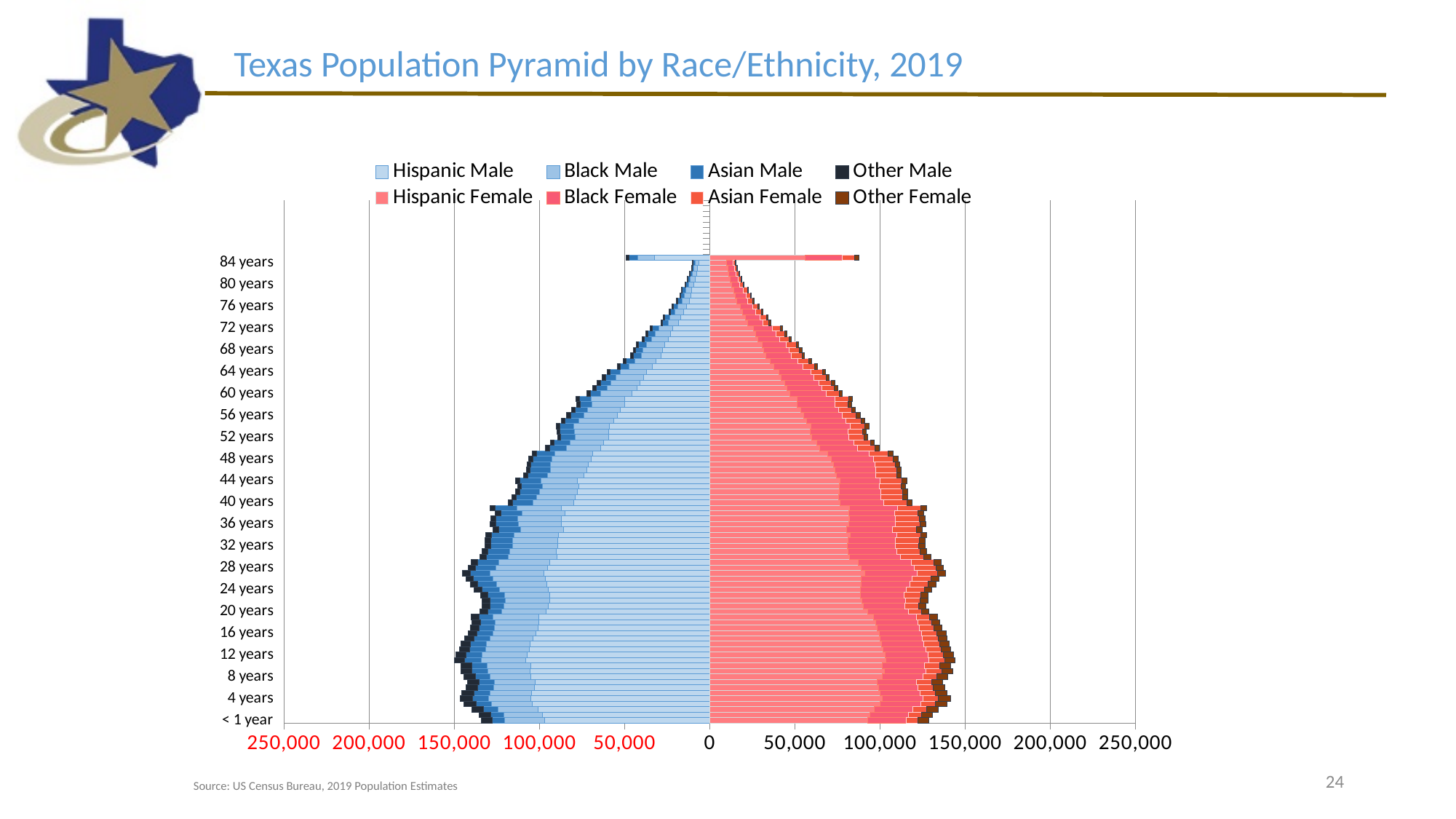
Which legend entries represent the female population? Hispanic Female, Black Female, Asian Female, Other Female Is the total male bar for 28 years greater or less than 100,000? greater Is the total male bar for 76 years greater or less than 50,000? less Which is larger, the total male bar for 28 years or the total male bar for 60 years? 28 years Is the total male bar for 84 years greater or less than 100,000? less How many series does the legend list? 8 What kind of chart is shown on the slide? bar chart What is the title of the chart? Texas Population Pyramid by Race/Ethnicity, 2019 Moving from the youngest ages at the bottom to the oldest ages at the top, do the bar lengths generally increase or decrease? decrease How many age labels are shown on the vertical axis? 22